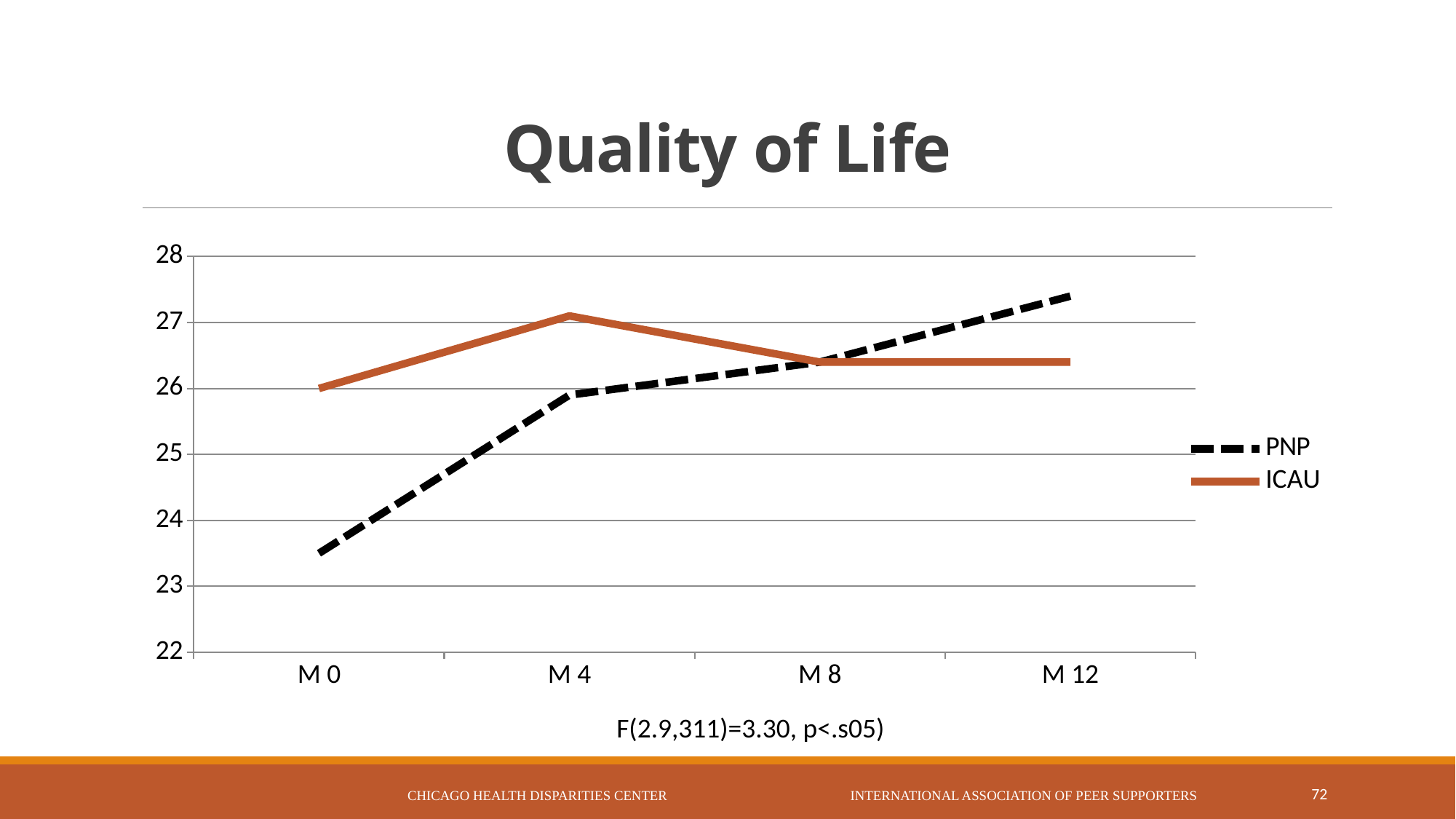
At which time point is the ICAU series highest? M 4 What is the value for ICAU at M 0? 26 Does the PNP series rise or fall from M 0 to M 12? rise What kind of chart is shown on the slide? line chart At which time point is the PNP series lowest? M 0 Is the value for PNP at M 0 greater or less than 24? less How many series does the legend list? 2 Is the value for PNP at M 12 greater or less than 27? greater At M 12, which series has the higher value, PNP or ICAU? PNP At M 0, which series has the higher value, PNP or ICAU? ICAU How many time points are shown on the x axis? 4